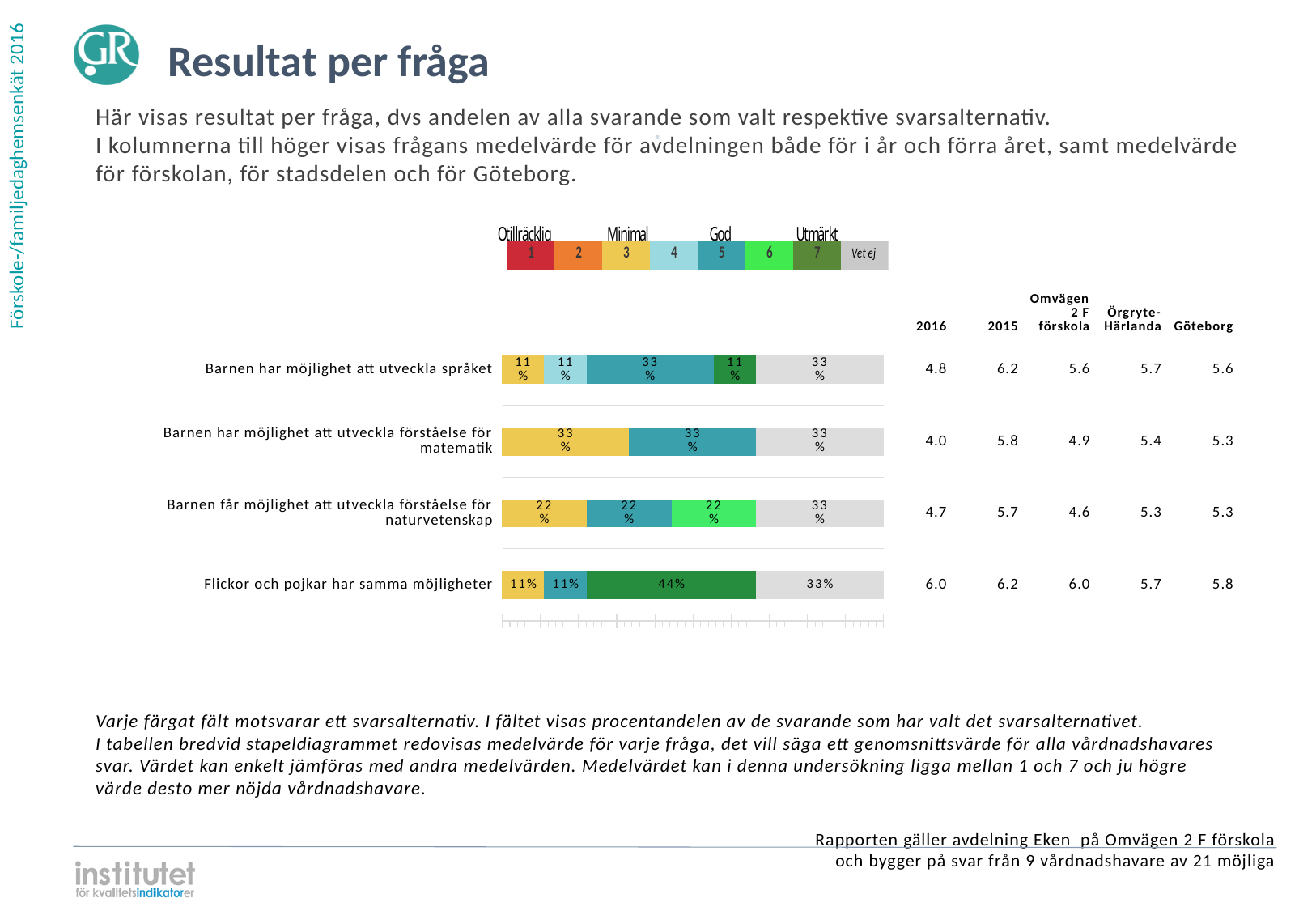
Which response option is labelled 'Utmärkt' in the legend? 7 What is the difference between the option 7 share (44%) and the option 3 share (11%) for 'Flickor och pojkar har samma möjligheter'? 33% Which question has the largest single segment in its bar? Flickor och pojkar har samma möjligheter What percentage of respondents chose 'Vet ej' for 'Flickor och pojkar har samma möjligheter'? 33% For 'Barnen har möjlighet att utveckla språket', which is larger: the share for option 5 (God) or the share for option 7 (Utmärkt)? Option 5 (God) How many questions (categories) are plotted in the bar chart? 4 How many response options does the legend above the chart list? 8 What percentage of respondents chose option 6 for 'Barnen får möjlighet att utveckla förståelse för naturvetenskap'? 22% What percentage of respondents chose option 7 (Utmärkt) for 'Flickor och pojkar har samma möjligheter'? 44% What kind of chart is shown on the slide? Stacked bar chart What percentage of respondents chose option 3 (Minimal) for 'Barnen har möjlighet att utveckla förståelse för matematik'? 33% What is the 2016 mean value shown for 'Flickor och pojkar har samma möjligheter'? 6.0